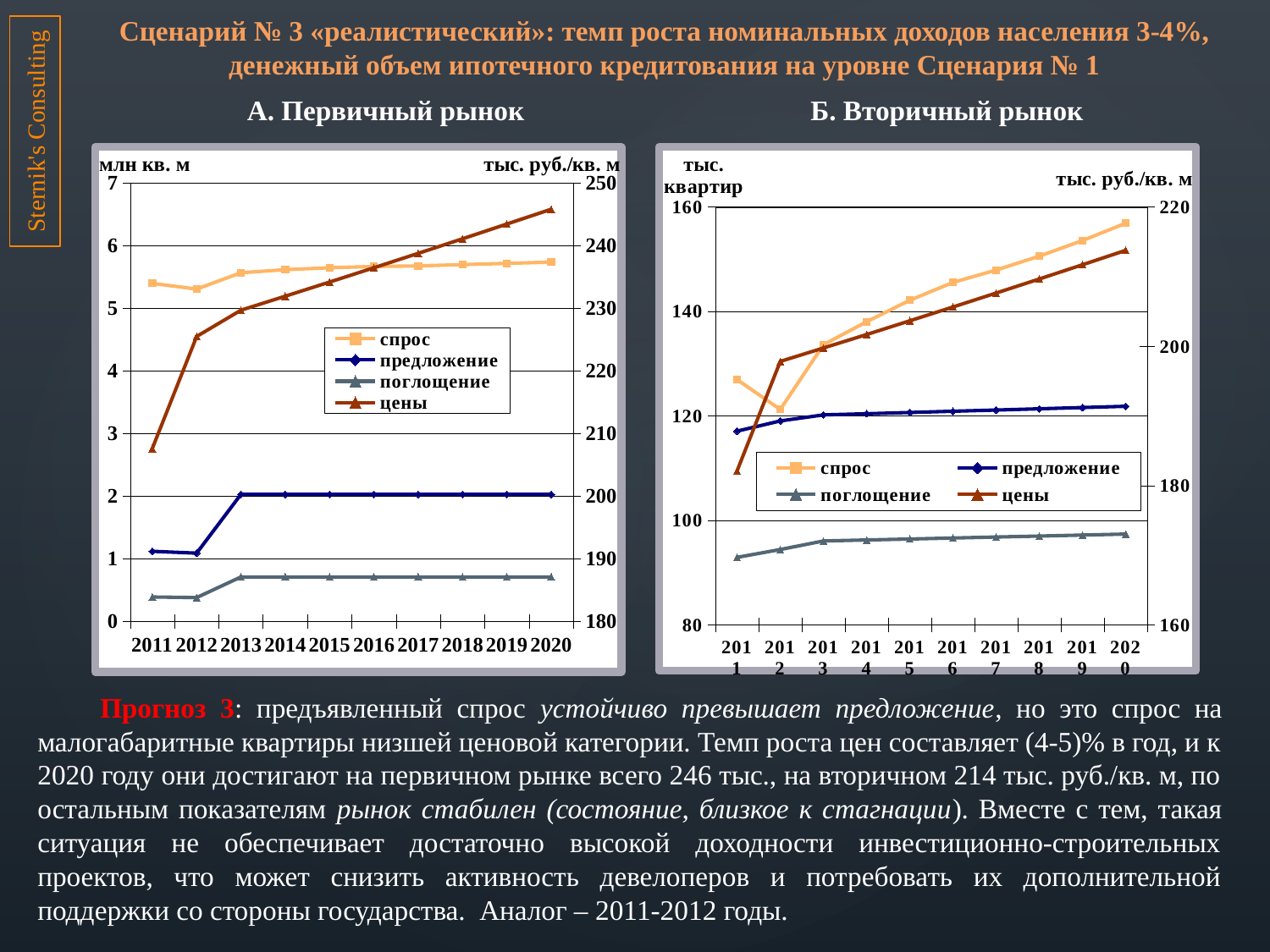
In the chart «А. Первичный рынок», do the values of the «цены» series rise or fall from 2011 to 2020? rise In the chart «А. Первичный рынок», is the value of «предложение» in 2011 greater or less than 2? less In the chart «Б. Вторичный рынок», is the value of «поглощение» in 2011 greater or less than 100? less In the chart «А. Первичный рынок», is the value of «цены» in 2011 greater or less than 220? less In the chart «А. Первичный рынок», which is larger in 2020: «спрос» or «предложение»? спрос In the chart «Б. Вторичный рынок», in which year is the «цены» series at its lowest? 2011 What unit is shown on the right-hand axis of the chart «Б. Вторичный рынок»? тыс. руб./кв. м What kind of chart is the chart titled «А. Первичный рынок»? line chart How many years are shown on the x axis of the chart «А. Первичный рынок»? 10 How many series does the legend of the chart «Б. Вторичный рынок» list? 4